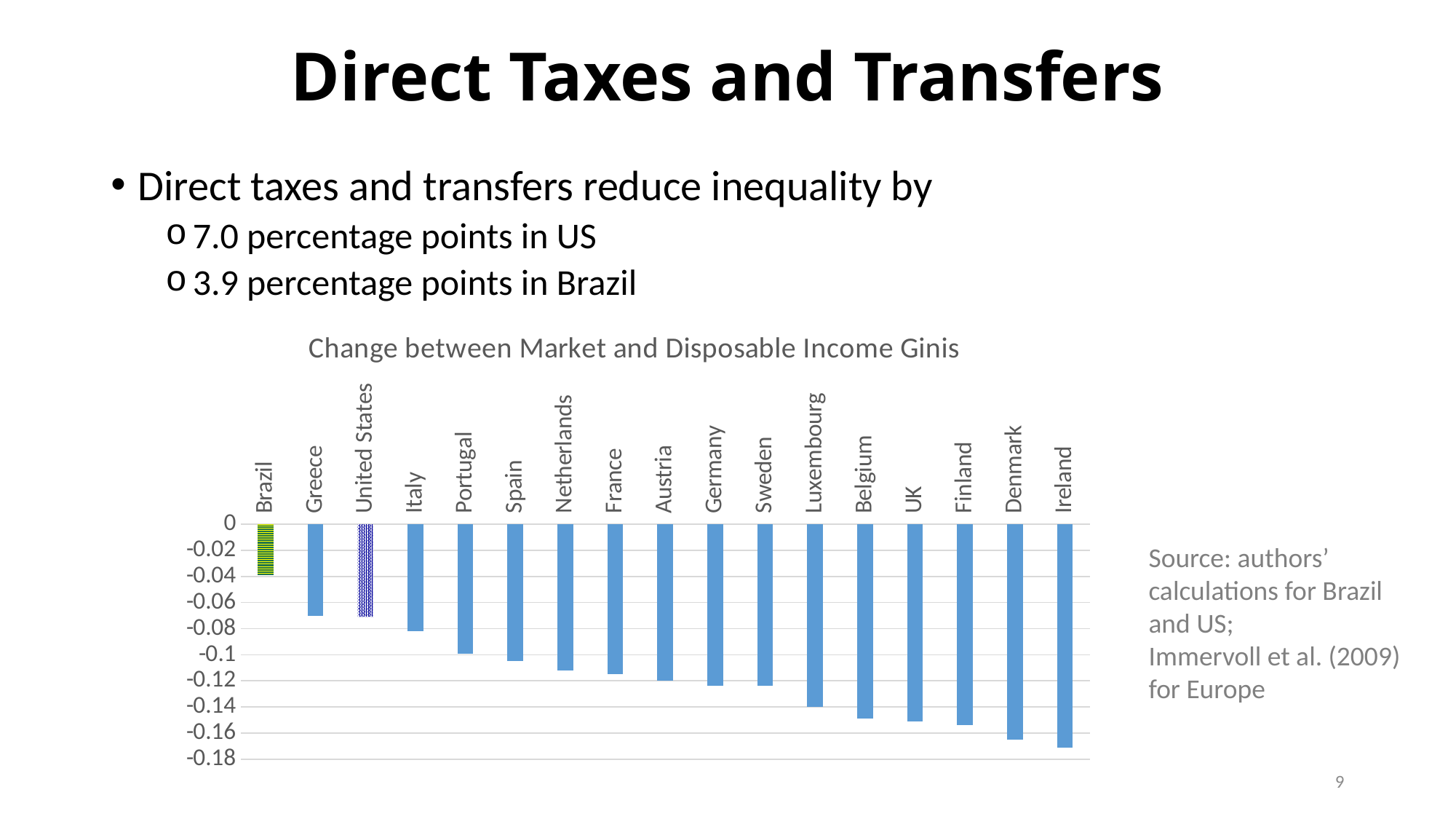
Do the bars get longer (more negative) or shorter moving from left to right along the x axis? Longer (more negative) Is the value for Italy greater or less than -0.1? greater How many countries are plotted in the chart? 17 Is the value for Luxembourg greater or less than -0.12? less Which country has the smallest change (shortest bar) in the chart? Brazil What kind of chart is shown on the slide? Bar chart Is the value for Brazil greater or less than -0.06? greater Which two bars are drawn with a patterned fill instead of solid blue? Brazil and United States Which country has the largest (most negative) change between market and disposable income Ginis? Ireland Which bar is longer (more negative), Denmark or Portugal? Denmark What is the title of the chart? Change between Market and Disposable Income Ginis